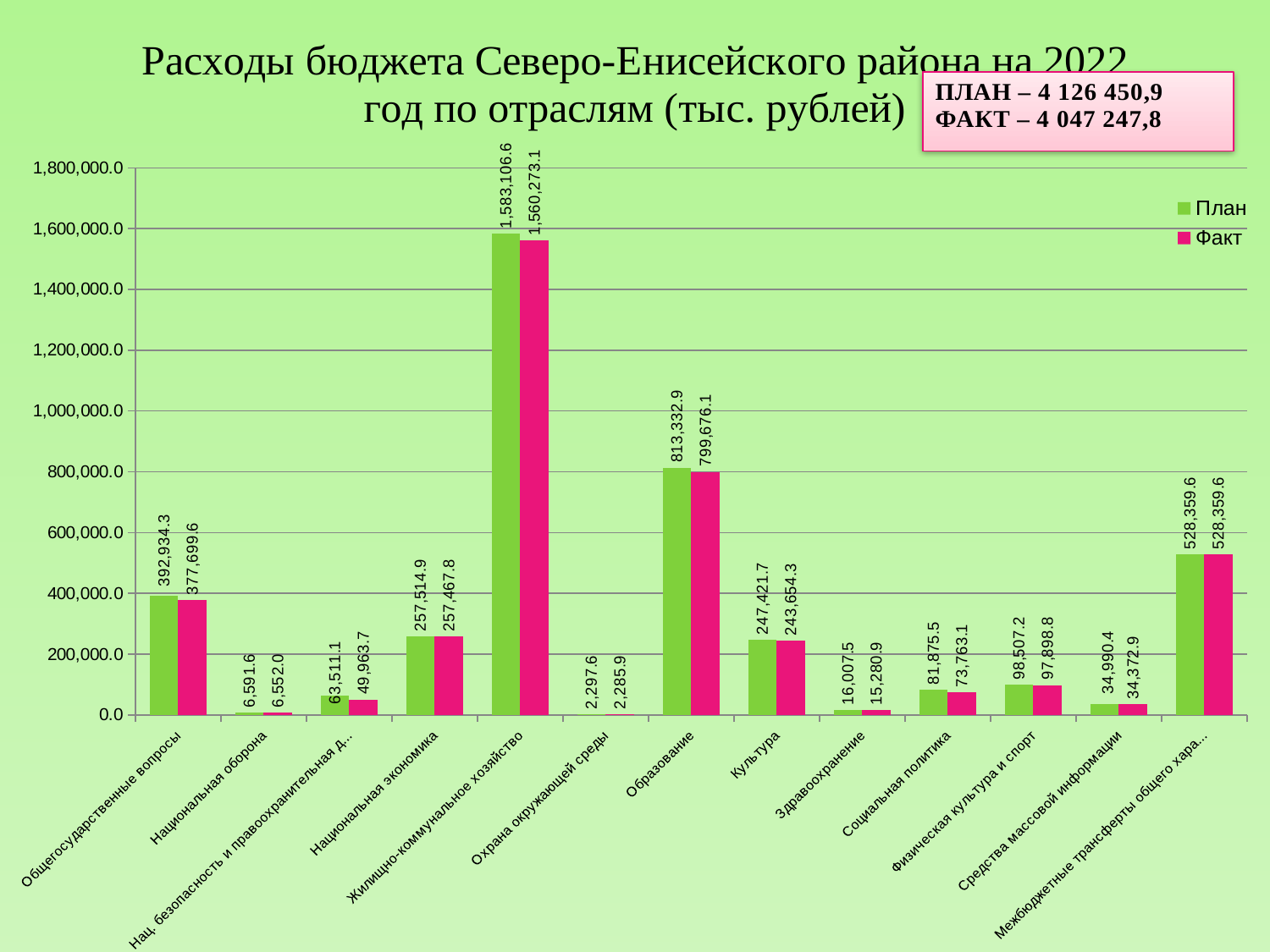
What is the План value for Образование? 813,332.9 Is the План value for Общегосударственные вопросы greater or less than 400,000.0? less How many categories are shown on the x axis? 13 Which category has the lowest Факт value? Охрана окружающей среды Which is larger, the Факт value for Культура or the Факт value for Физическая культура и спорт? Культура What is the difference between the План and Факт values for Образование? 13,656.8 What is the Факт value for Социальная политика? 73,763.1 What is the difference between the План and Факт values for Социальная политика? 8,112.4 Which category has the highest План value? Жилищно-коммунальное хозяйство What is the Факт value for Жилищно-коммунальное хозяйство? 1,560,273.1 How many series does the legend list? 2 What kind of chart is shown on the slide? bar chart